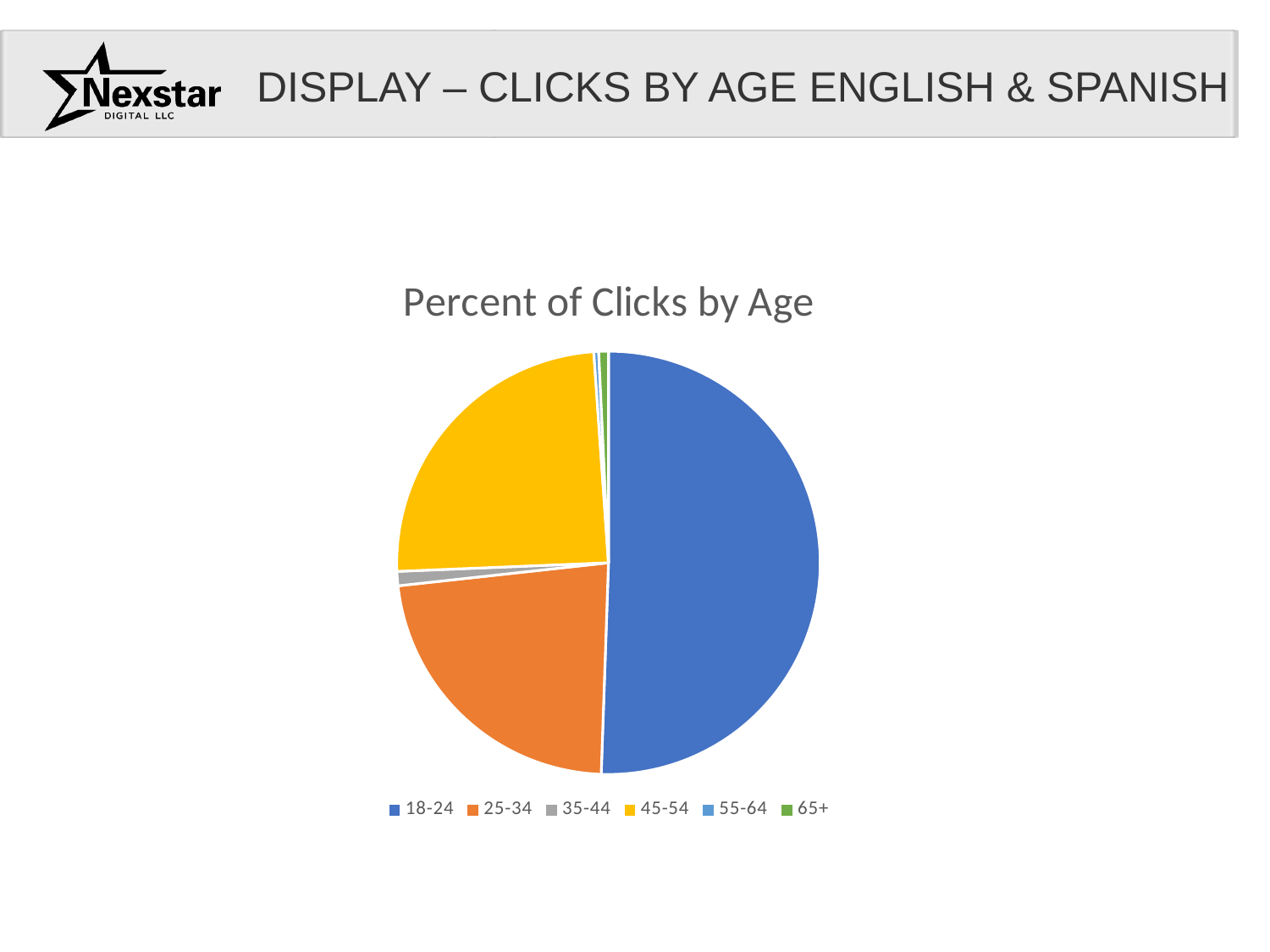
Which has a larger share of clicks, 35-44 or 55-64? 35-44 How many age groups does the legend list? 6 How many slices does the pie chart have? 6 Which has a larger share of clicks, 18-24 or 25-34? 18-24 Which age group has the largest share of clicks? 18-24 Which has a larger share of clicks, 45-54 or 35-44? 45-54 What is the title of the chart? Percent of Clicks by Age What kind of chart is shown on the slide? pie chart Which colour represents the 45-54 age group in the chart? yellow